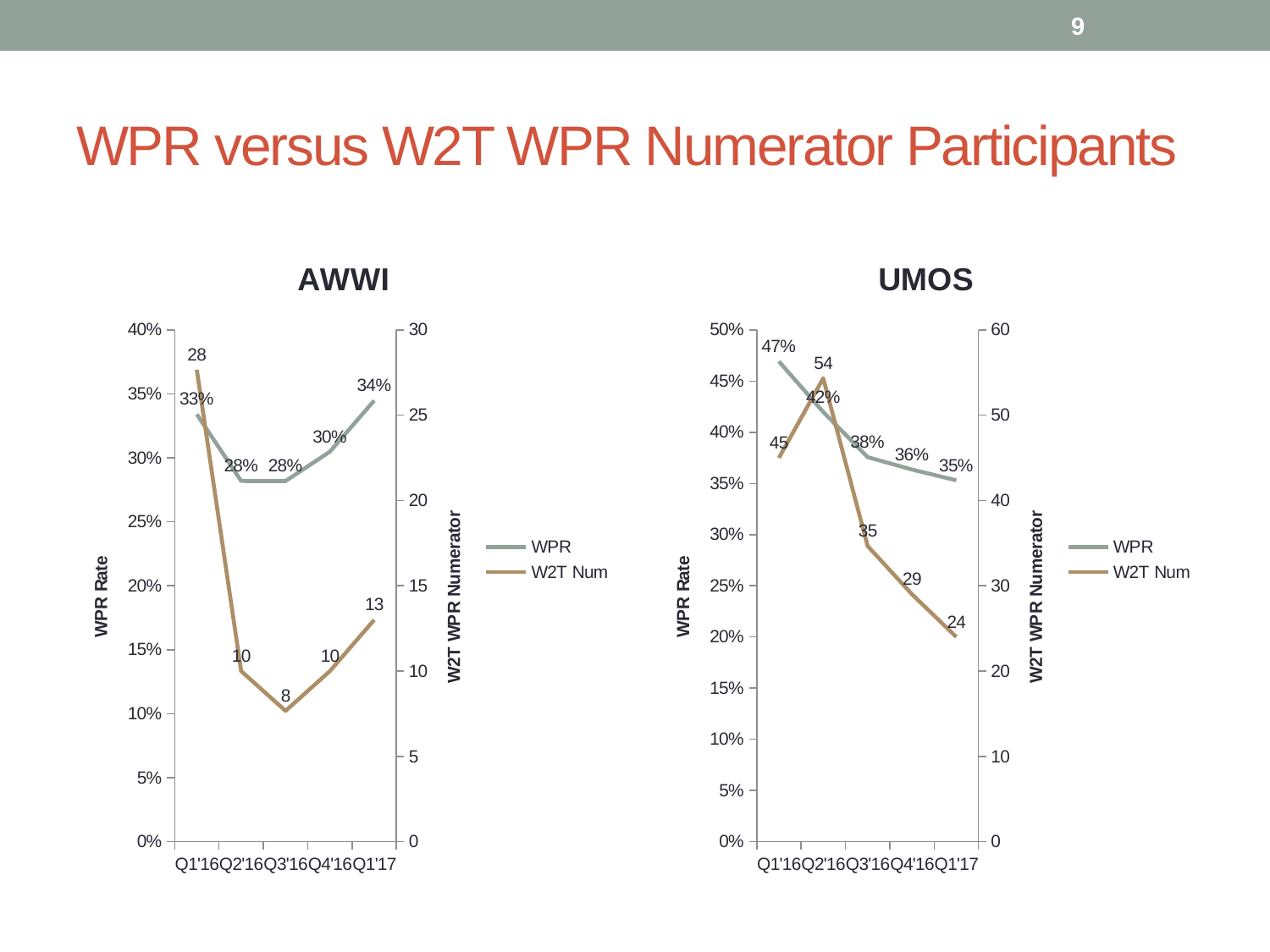
In the AWWI chart, what is the W2T Num value for Q3'16? 8 In the UMOS chart, what is the W2T Num value for Q2'16? 54 How many series does the legend of the AWWI chart list? 2 In the AWWI chart, which is larger, the W2T Num value for Q1'16 or for Q1'17? Q1'16 In the AWWI chart, what is the WPR value for Q1'17? 34% In the UMOS chart, what is the WPR value for Q4'16? 36% What kind of chart is the UMOS chart? Line chart In the UMOS chart, which quarter has the highest WPR? Q1'16 In the UMOS chart, does the WPR series rise or fall from Q1'16 to Q1'17? Fall In the AWWI chart, which quarter has the lowest W2T Num value? Q3'16 In the UMOS chart, what is the difference between the W2T Num values for Q2'16 and Q1'17? 30 How many quarters are shown on the x axis of the UMOS chart? 5